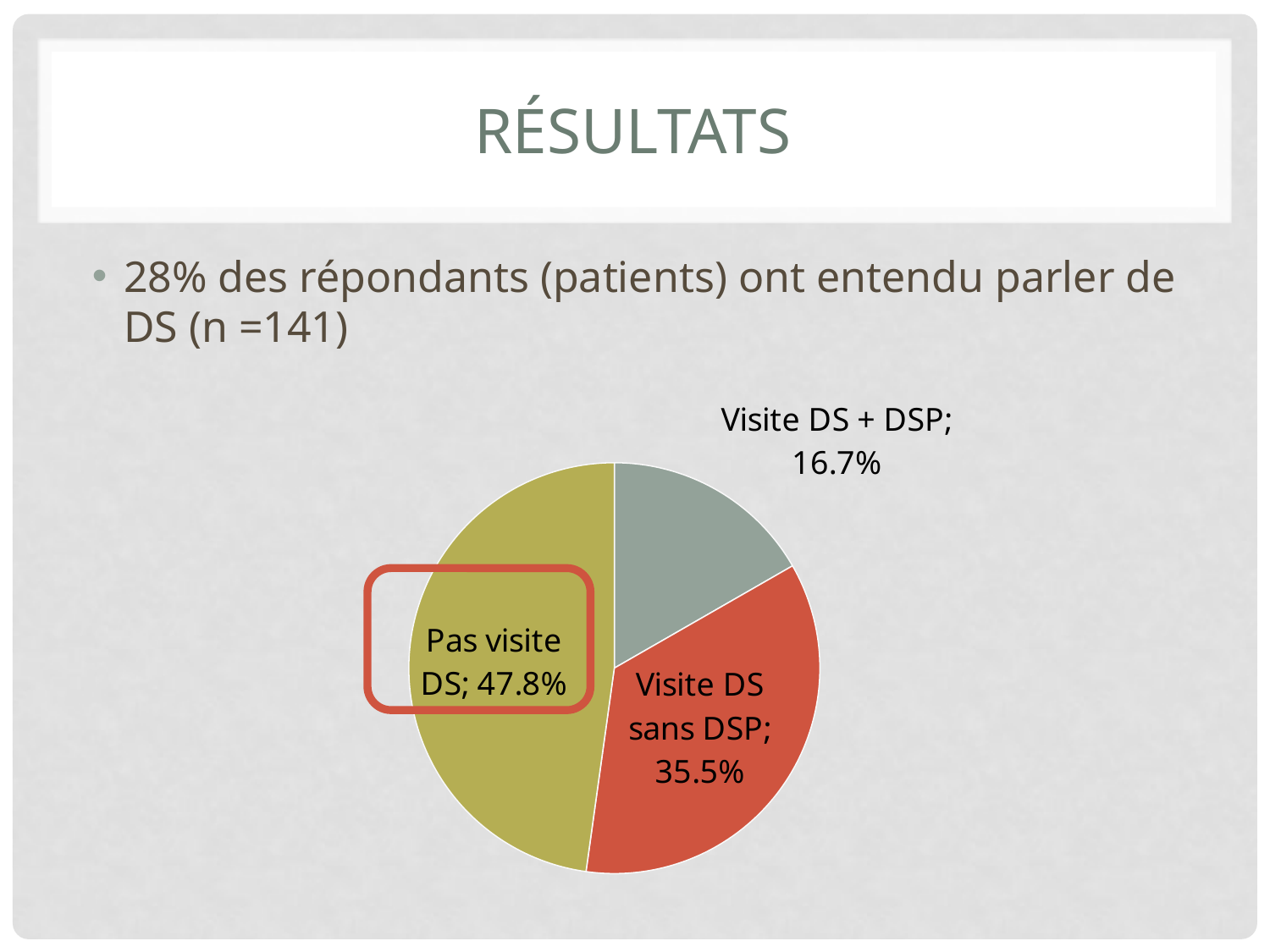
What is the difference between the "Visite DS sans DSP" and "Visite DS + DSP" slices? 18.8% What share of the pie does the "Pas visite DS" slice represent? 47.8% What is the difference between the "Pas visite DS" and "Visite DS sans DSP" slices? 12.3% Which slice of the pie is the largest? Pas visite DS Which is larger, "Visite DS sans DSP" or "Visite DS + DSP"? Visite DS sans DSP What kind of chart is shown on the slide? Pie chart What is the value shown for "Visite DS + DSP"? 16.7% Which slice of the pie is the smallest? Visite DS + DSP What is the value shown for "Visite DS sans DSP"? 35.5% Which slice of the pie is highlighted with a red rounded rectangle? Pas visite DS What colour is the "Visite DS sans DSP" slice? Red How many slices does the pie chart have? 3